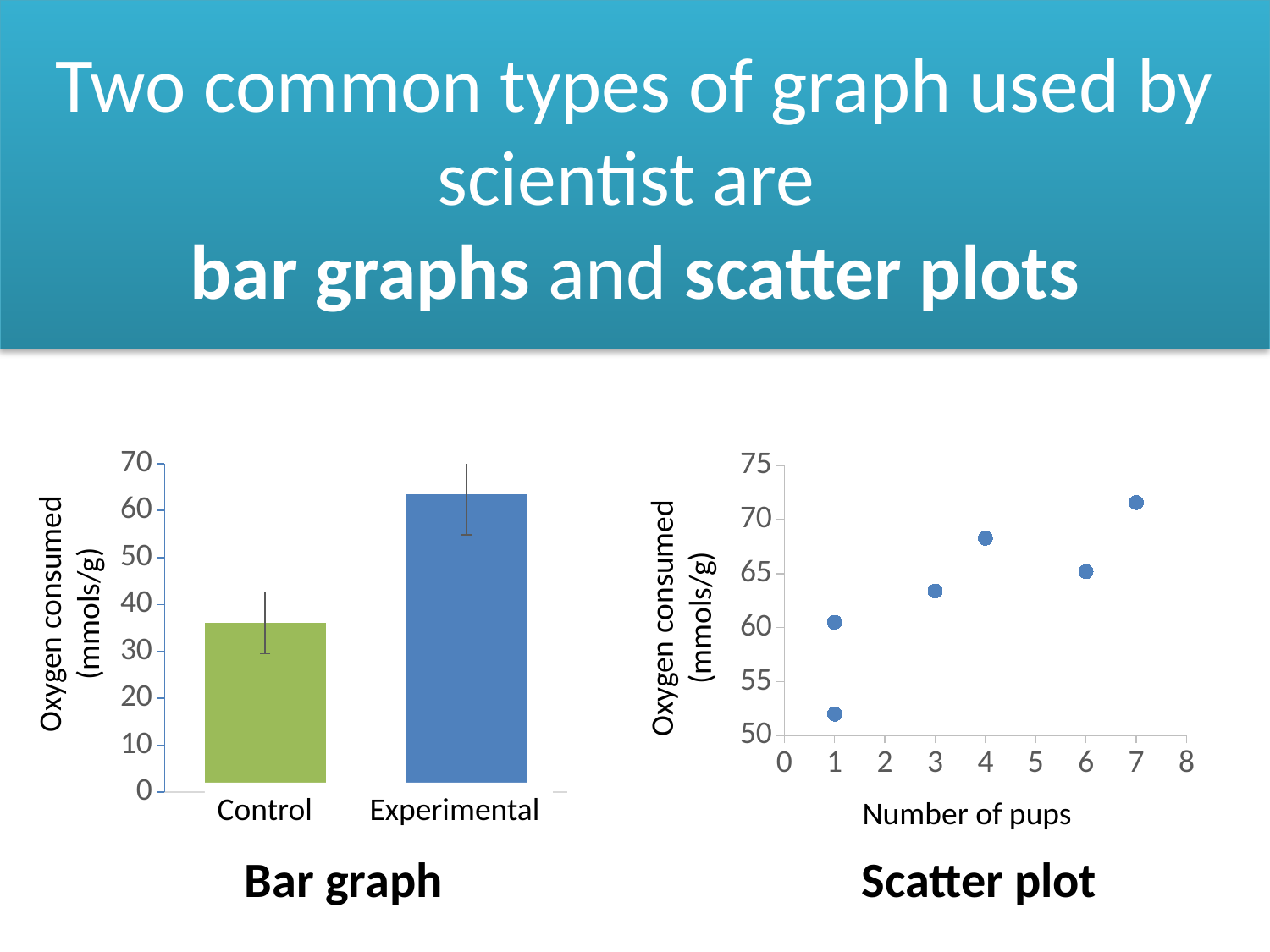
In the bar graph on the left, how many categories are shown on the x axis? 2 In the bar graph on the left, is the value for Control greater or less than 40? less In the bar graph on the left, is the value for Control greater or less than 30? greater What kind of chart is the chart on the left of the slide? bar chart What kind of chart is the chart on the right of the slide? scatter plot In the bar graph on the left, which category has the higher value, Control or Experimental? Experimental In the scatter plot on the right, at which number of pups is the highest oxygen consumed value plotted? 7 In the scatter plot on the right, at which number of pups is the lowest oxygen consumed value plotted? 1 In the bar graph on the left, is the value for Experimental greater or less than 60? greater What is the x-axis title of the scatter plot on the right? Number of pups In the scatter plot on the right, how many data points are plotted? 6